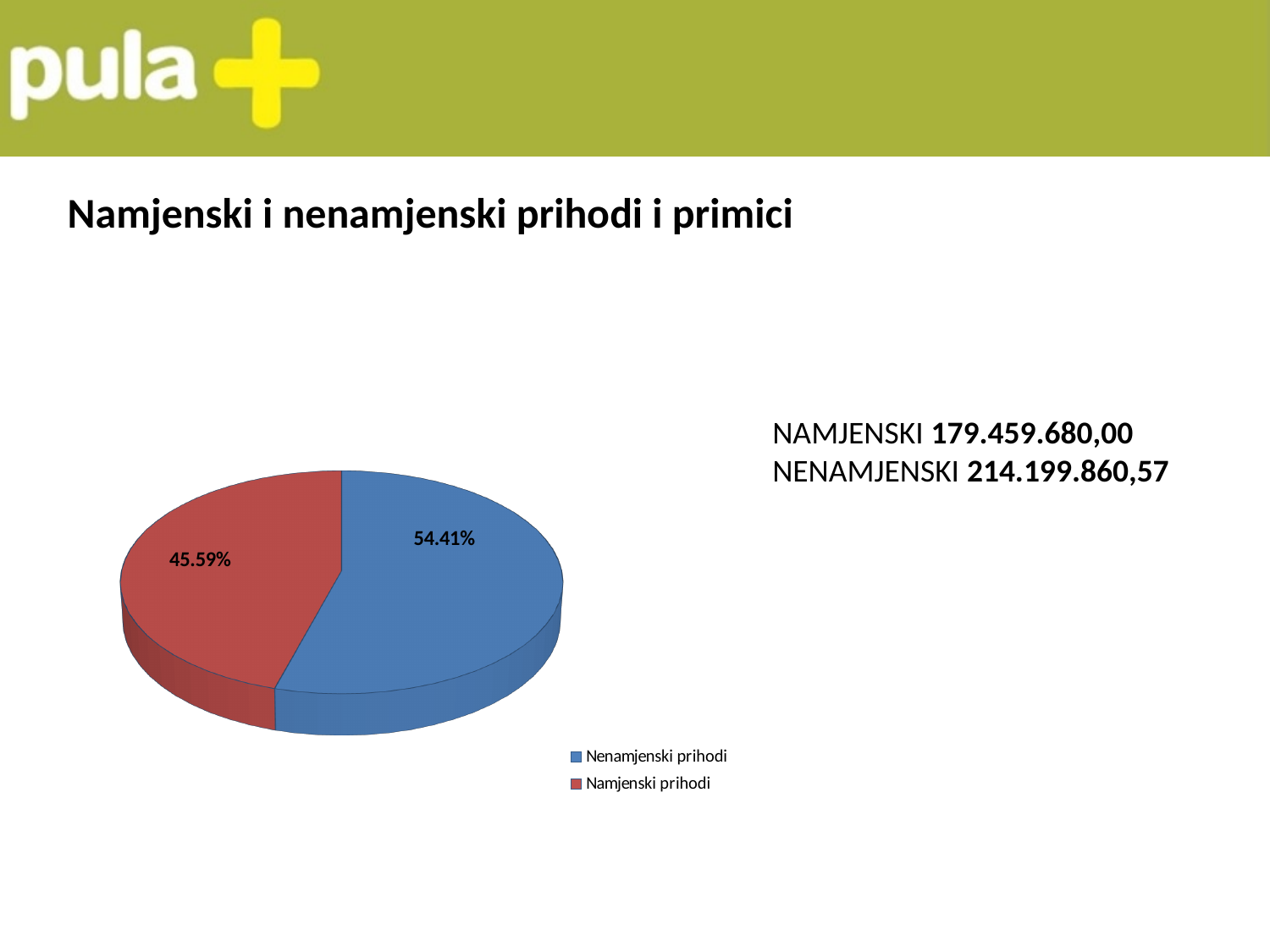
What colour is the Namjenski prihodi slice? red What kind of chart is shown on the slide? pie chart Is the share for Namjenski prihodi greater or less than 50%? less Which is larger, the share for Nenamjenski prihodi or the share for Namjenski prihodi? Nenamjenski prihodi What is the difference in percentage points between the Nenamjenski prihodi share and the Namjenski prihodi share? 8.82 percentage points How many slices does the pie chart have? 2 Which slice of the pie is the smallest? Namjenski prihodi Which slice of the pie is the largest? Nenamjenski prihodi What share of the pie does Namjenski prihodi represent? 45.59% How many entries does the legend list? 2 What colour is the Nenamjenski prihodi slice? blue What share of the pie does Nenamjenski prihodi represent? 54.41%